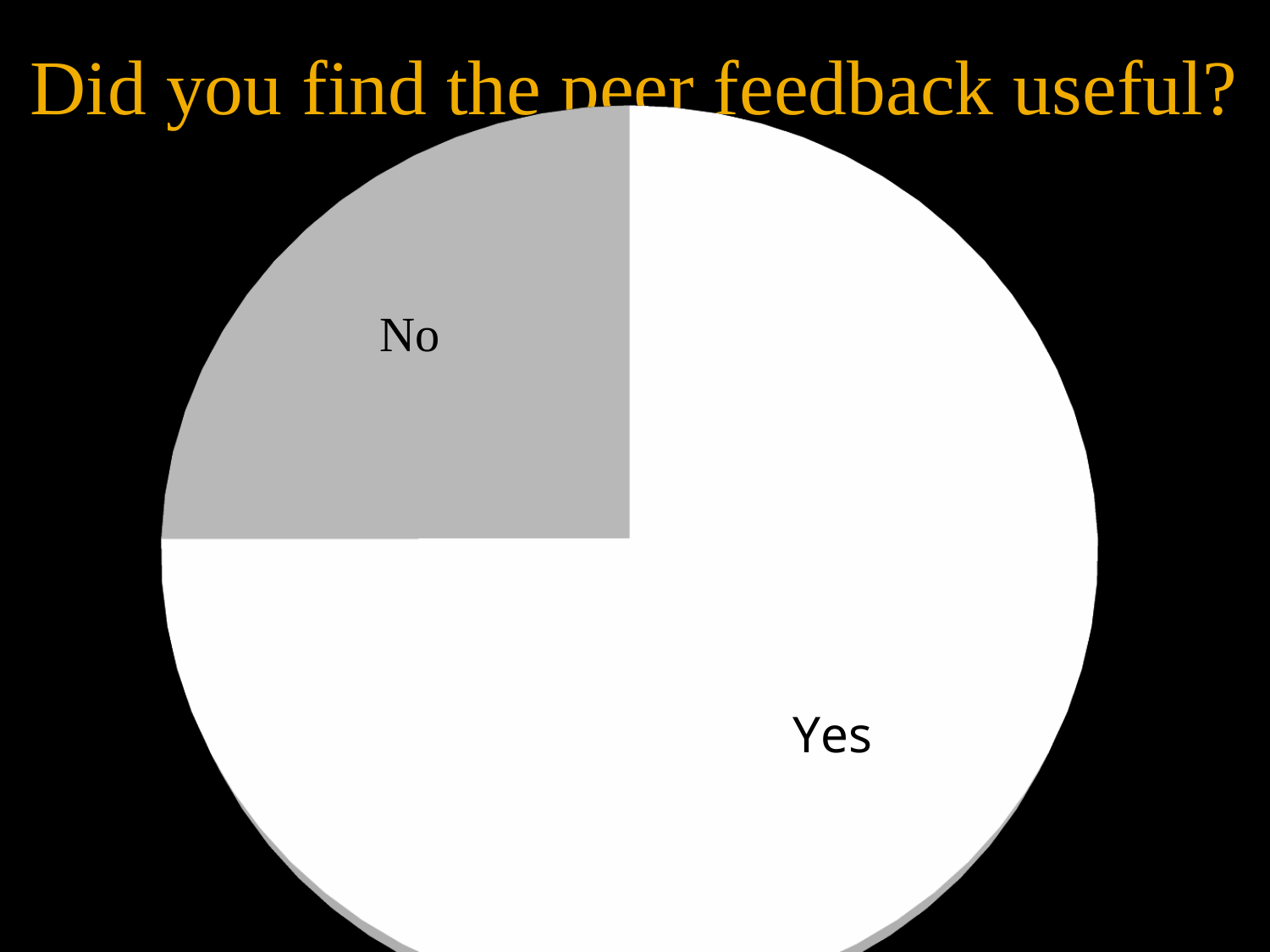
What kind of chart is shown on the slide? pie chart What is the title of the chart? Did you find the peer feedback useful? Which slice of the pie chart is the largest? Yes Which slice of the pie chart is the smallest? No How many slices does the pie chart have? 2 Which slice is larger, Yes or No? Yes What colour is the No slice of the pie chart? grey